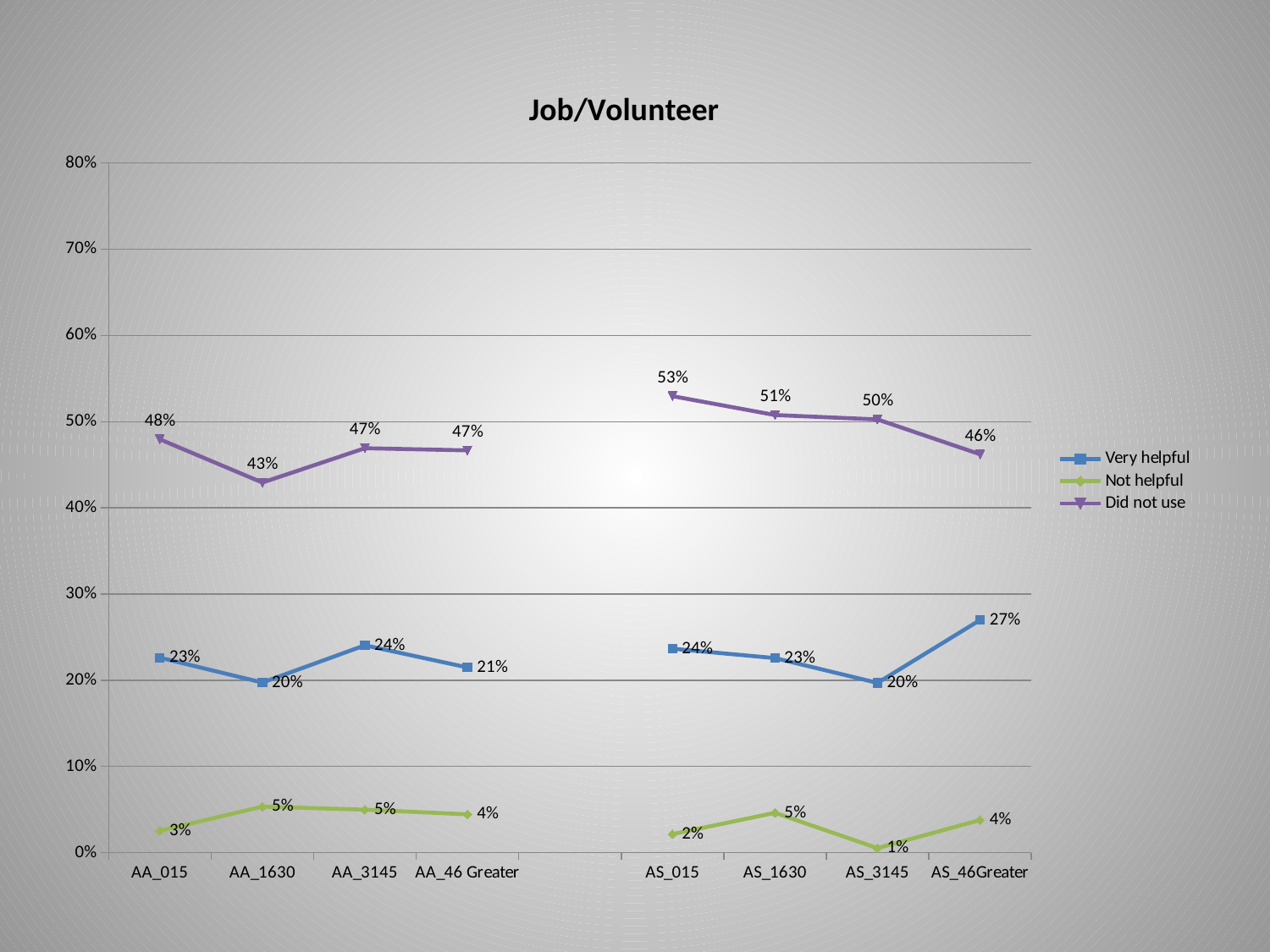
How many categories are shown on the x axis? 8 What is the value of the Did not use series for AA_1630? 43% Which category has the lowest value for the Not helpful series? AS_3145 Which is larger, the Very helpful value for AA_3145 or for AS_46Greater? AS_46Greater What is the value of the Not helpful series for AS_3145? 1% What kind of chart is this? Line chart Which category has the highest value for the Did not use series? AS_015 What is the title of the chart? Job/Volunteer How many series does the legend list? 3 What is the value of the Did not use series for AS_015? 53% What is the difference between the Did not use values for AS_015 and AA_1630? 10% What is the value of the Very helpful series for AS_46Greater? 27%